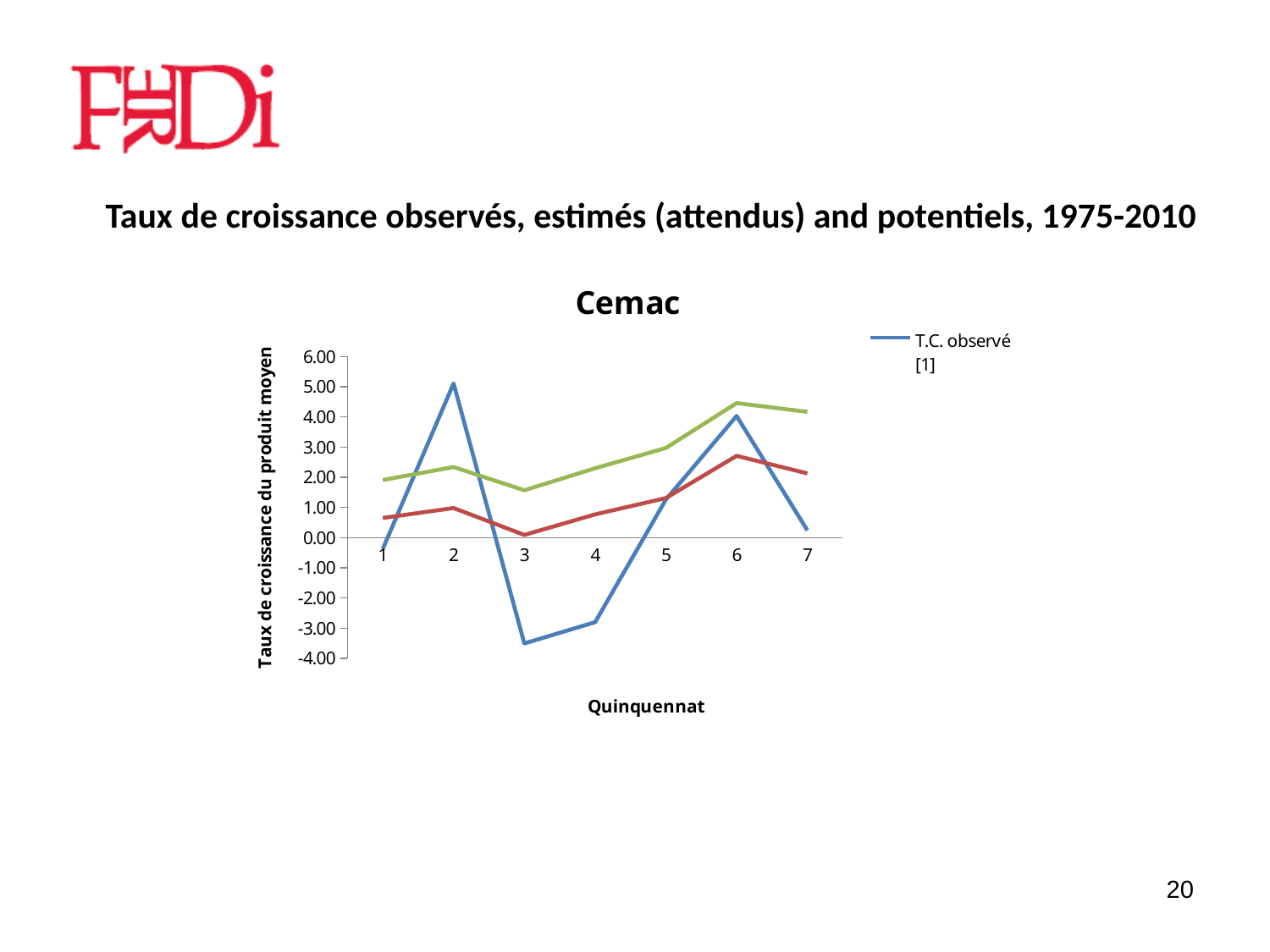
At which quinquennat does the T.C. observé (blue) line reach its lowest value? 3 How many quinquennats (points) are shown along the x axis? 7 At quinquennat 6, which is higher: the green line or the red line? the green line At which quinquennat does the T.C. observé (blue) line reach its highest value? 2 Does the red line rise or fall from quinquennat 3 to quinquennat 6? rise At which quinquennat does the green line reach its highest value? 6 Is the value of the T.C. observé (blue) line at quinquennat 3 greater or less than -3.00? less Is the value of the T.C. observé (blue) line at quinquennat 2 greater or less than 4.00? greater How many lines are plotted on the chart? 3 What is the label of the x axis of the chart? Quinquennat What kind of chart is shown on the slide? line chart What is the title of the chart? Cemac